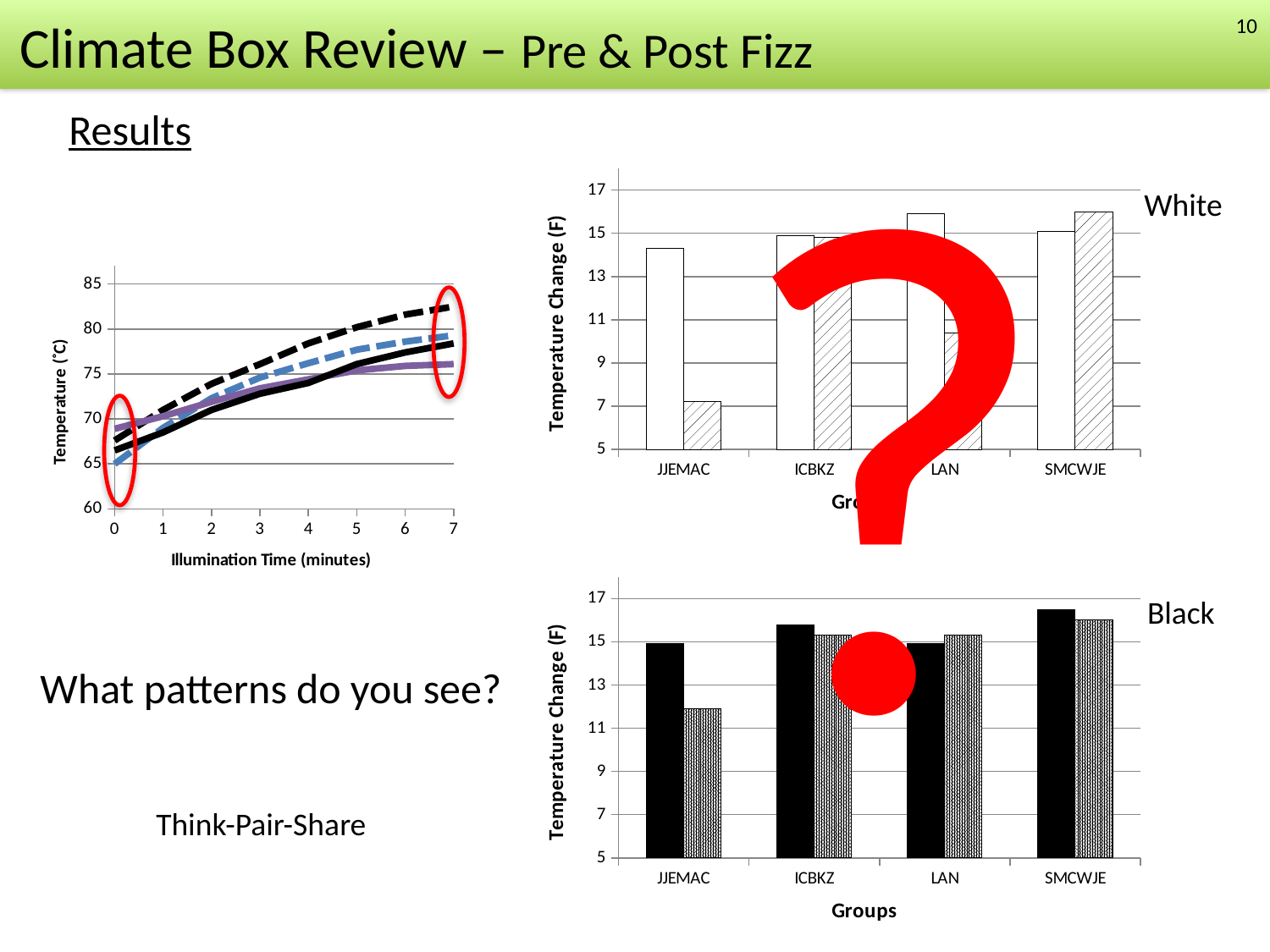
In the line chart on the left, do the lines generally rise or fall as illumination time increases? rise What kind of chart is the chart on the left of the slide? line chart In the 'White' chart at the top right, which group has the lowest hatched bar? JJEMAC In the 'White' chart at the top right, is the hatched bar for JJEMAC greater or less than 9? less In the 'Black' chart at the bottom right, what is the y-axis label? Temperature Change (F) In the 'Black' chart at the bottom right, is the hatched bar for JJEMAC greater or less than 13? less In the line chart on the left, is the value of the black dashed line at 7 minutes greater or less than 80? greater In the line chart on the left, what is the x-axis label? Illumination Time (minutes) In the 'White' chart at the top right, how many groups are shown on the x axis? 4 What kind of chart is the 'White' chart at the top right? bar chart In the 'Black' chart at the bottom right, which group has the highest solid black bar? SMCWJE In the 'White' chart at the top right, which is larger for JJEMAC, the solid white bar or the hatched bar? the solid white bar